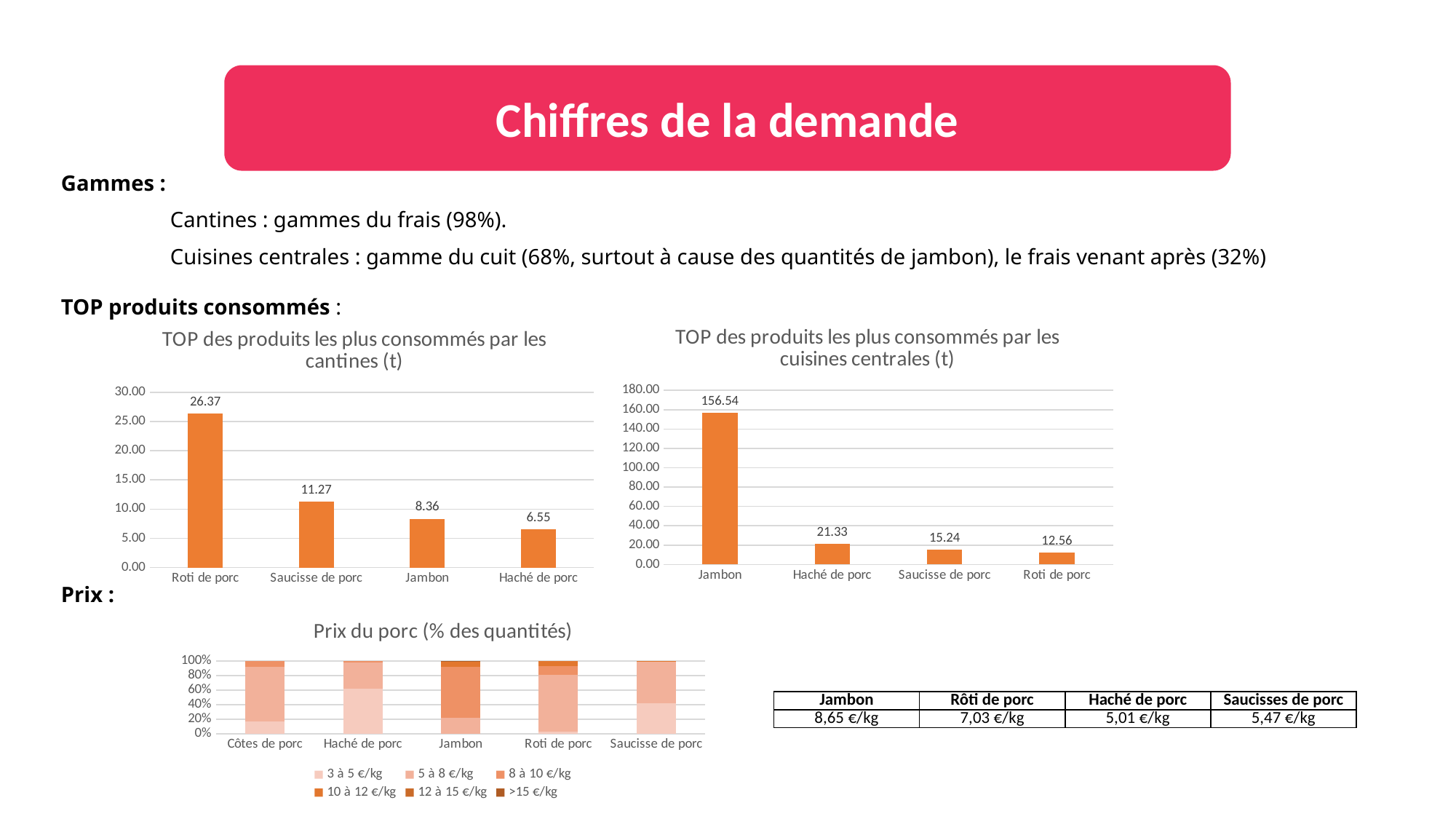
In the chart 'Prix du porc (% des quantités)', is the share of '3 à 5 €/kg' for Haché de porc greater or less than 40%? greater In the chart 'TOP des produits les plus consommés par les cuisines centrales (t)', do the values rise or fall from left to right? fall In the chart 'TOP des produits les plus consommés par les cuisines centrales (t)', what is the difference between Jambon and Roti de porc? 143.98 In the chart 'TOP des produits les plus consommés par les cantines (t)', what is the value for Roti de porc? 26.37 In the chart 'TOP des produits les plus consommés par les cuisines centrales (t)', which is larger: Haché de porc or Saucisse de porc? Haché de porc In the chart 'TOP des produits les plus consommés par les cuisines centrales (t)', which product has the highest value? Jambon What kind of chart is 'Prix du porc (% des quantités)'? stacked bar chart In the chart 'TOP des produits les plus consommés par les cantines (t)', how many products are shown? 4 In the chart 'TOP des produits les plus consommés par les cantines (t)', what is the difference between Saucisse de porc and Jambon? 2.91 In the chart 'TOP des produits les plus consommés par les cuisines centrales (t)', what is the value for Jambon? 156.54 In the chart 'TOP des produits les plus consommés par les cantines (t)', which product has the lowest value? Haché de porc How many series does the legend of the chart 'Prix du porc (% des quantités)' list? 6